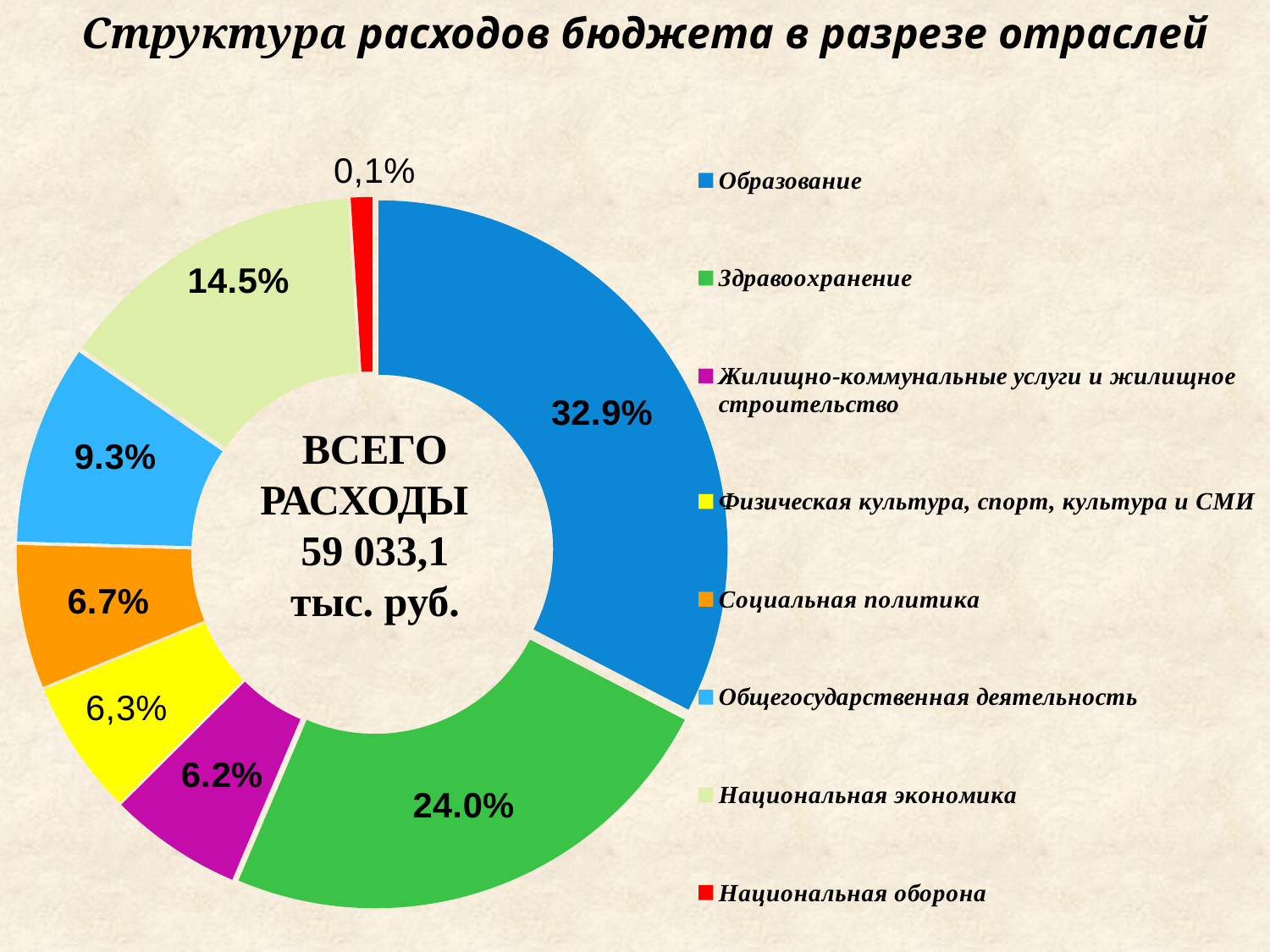
What share of budget expenditures goes to Общегосударственная деятельность? 9.3% What total expenditure amount is shown in the centre of the chart? 59 033,1 тыс. руб. Which has a larger share: Социальная политика or Общегосударственная деятельность? Общегосударственная деятельность Which sector has the smallest share of budget expenditures? Национальная оборона Which sector has the largest share of budget expenditures? Образование What share of budget expenditures goes to Национальная экономика? 14.5% What share of budget expenditures goes to Национальная оборона? 0,1% What share of budget expenditures goes to Образование? 32.9% What is the difference in percentage points between the shares of Образование and Здравоохранение? 8.9 What kind of chart is shown on the slide? doughnut chart How many sectors are shown in the chart? 8 What share of budget expenditures goes to Здравоохранение? 24.0%